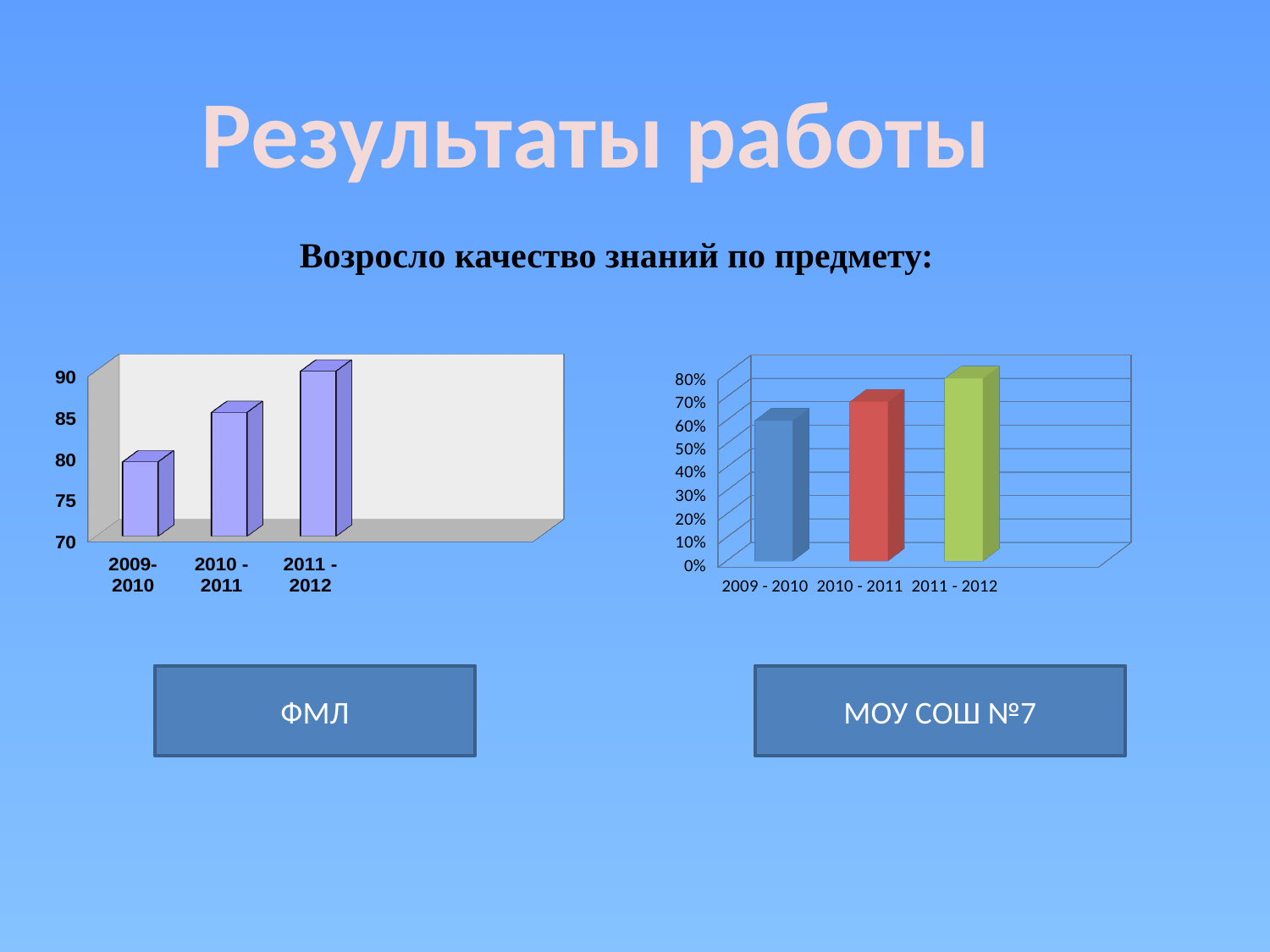
How many categories are shown in the right chart (МОУ СОШ №7)? 3 In the left chart (ФМЛ), which period has the lowest bar? 2009-2010 What kind of chart is the left chart (ФМЛ)? bar chart In the left chart (ФМЛ), which period has the highest bar? 2011 - 2012 What kind of chart is the right chart (МОУ СОШ №7)? bar chart In the left chart (ФМЛ), do the values rise or fall from 2009-2010 to 2011 - 2012? rise In the right chart (МОУ СОШ №7), which period has the lowest value? 2009 - 2010 In the right chart (МОУ СОШ №7), which is larger, the value for 2010 - 2011 or the value for 2009 - 2010? 2010 - 2011 In the right chart (МОУ СОШ №7), which period has the highest value? 2011 - 2012 In the right chart (МОУ СОШ №7), is the value for 2009 - 2010 greater or less than 70%? less How many bars are shown in the left chart (ФМЛ)? 3 In the left chart (ФМЛ), is the value for 2009-2010 greater or less than 85? less